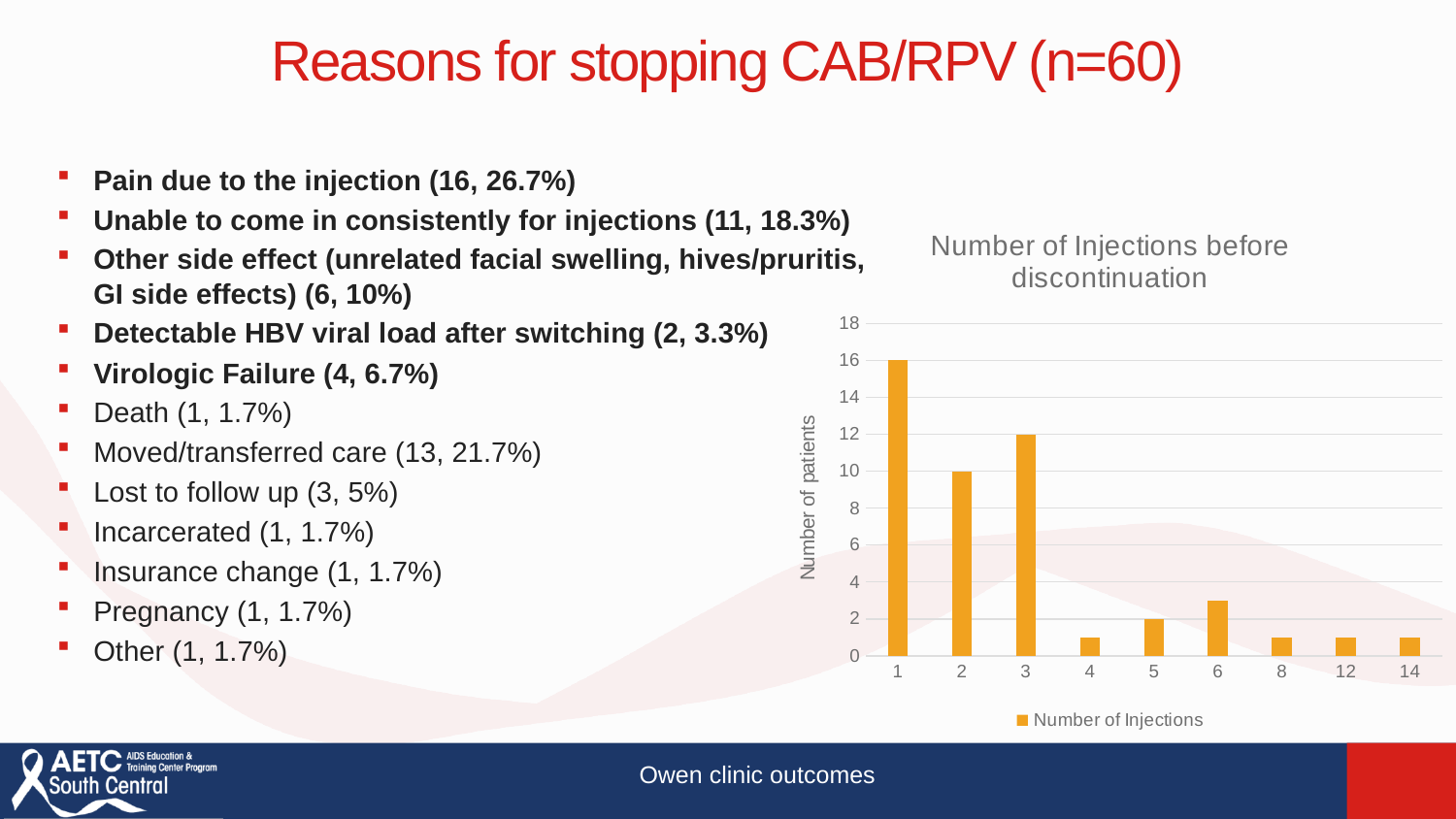
How many categories are shown on the x axis of the chart? 9 Is the number of patients for 6 injections greater or less than 2? greater What is the difference in number of patients between 1 injection and 2 injections? 6 What is the title of the chart? Number of Injections before discontinuation What kind of chart is shown on the slide? bar chart How many patients discontinued after 3 injections? 12 How many series does the chart legend list? 1 Which has more patients: 2 injections or 3 injections? 3 injections How many patients discontinued after 5 injections? 2 How many patients discontinued after 2 injections? 10 Which number of injections has the highest number of patients? 1 How many patients discontinued after 1 injection? 16